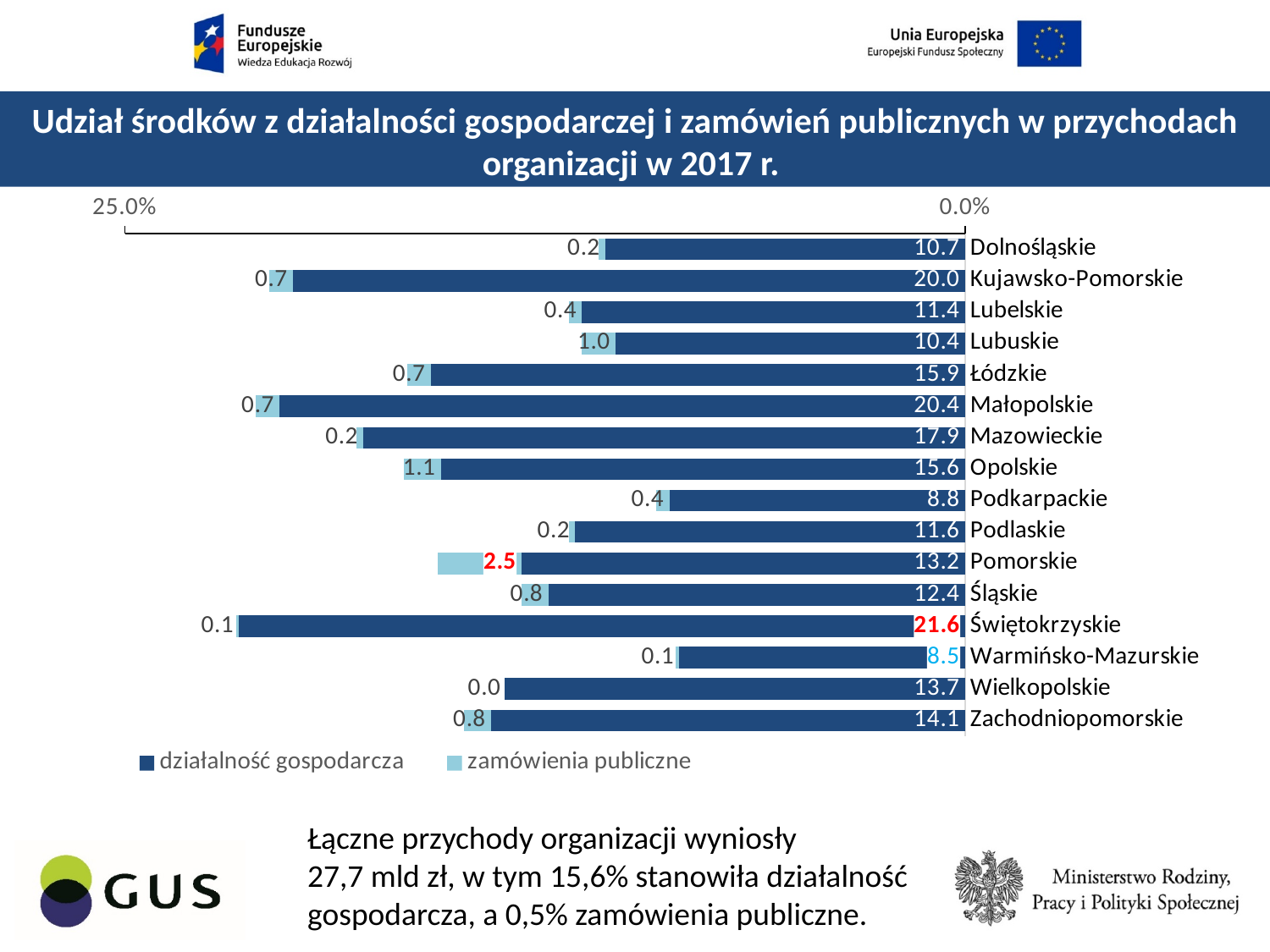
What is the value of działalność gospodarcza for Kujawsko-Pomorskie? 20.0 What is the value of działalność gospodarcza for Warmińsko-Mazurskie? 8.5 Which voivodeship has the lowest value for działalność gospodarcza? Warmińsko-Mazurskie Which voivodeship has the highest value for zamówienia publiczne? Pomorskie How many series does the legend list? 2 What is the difference between the działalność gospodarcza values for Świętokrzyskie and Warmińsko-Mazurskie? 13.1 Which has a larger działalność gospodarcza value, Mazowieckie or Lubelskie? Mazowieckie Which voivodeship has the highest value for działalność gospodarcza? Świętokrzyskie What is the total of the stacked bar for Pomorskie? 15.7 How many voivodeships are shown in the chart? 16 What kind of chart is shown on the slide? Stacked bar chart What is the value of zamówienia publiczne for Pomorskie? 2.5